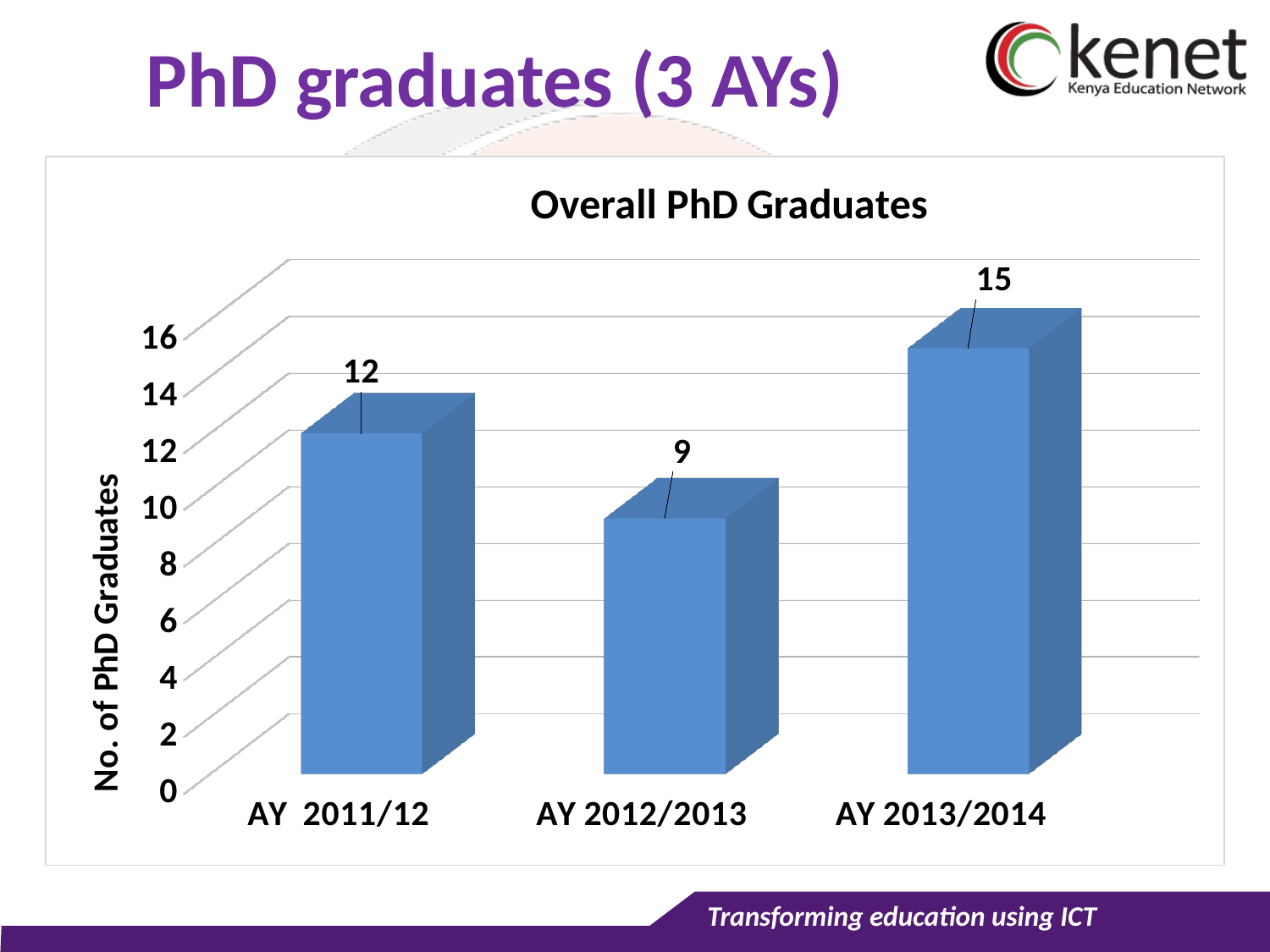
How many PhD graduates were there in AY 2013/2014? 15 Which academic year had the highest number of PhD graduates? AY 2013/2014 How many PhD graduates were there in AY 2012/2013? 9 How many PhD graduates were there in AY 2011/12? 12 What is the difference in PhD graduates between AY 2011/12 and AY 2012/2013? 3 What is the difference in PhD graduates between AY 2013/2014 and AY 2012/2013? 6 What is the title of the chart? Overall PhD Graduates Which academic year had the lowest number of PhD graduates? AY 2012/2013 How many academic years are shown on the chart? 3 What type of chart is used to show the PhD graduates? bar chart Is the number of PhD graduates in AY 2012/2013 greater or less than 10? less Which had more PhD graduates, AY 2011/12 or AY 2013/2014? AY 2013/2014